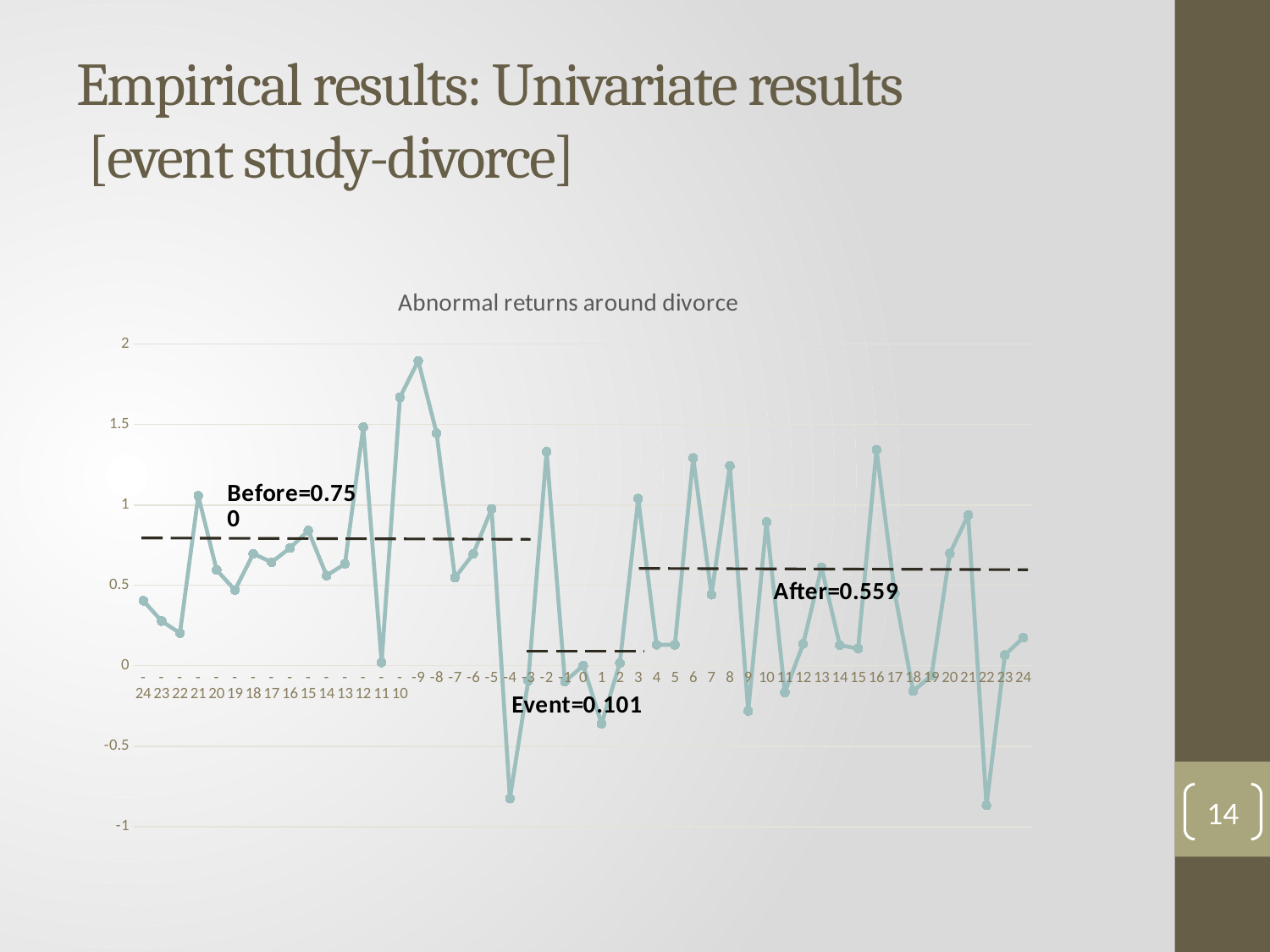
At which x-axis position does the line reach its highest value? -9 What is the abnormal return at the event, as annotated on the chart? 0.101 What is the average abnormal return before the divorce event, as annotated on the chart? 0.750 Which annotated average is larger, Before or After? Before How many data points are plotted on the line (x from -24 to 24)? 49 Is the value at x = -10 greater or less than 1.5? greater Is the value at x = -4 greater or less than -0.5? less What is the title of the chart? Abnormal returns around divorce What is the difference between the annotated Before average and the After average? 0.191 What is the average abnormal return after the divorce event, as annotated on the chart? 0.559 Is the value at x = 16 greater or less than 1? greater What type of chart is shown on the slide? line chart